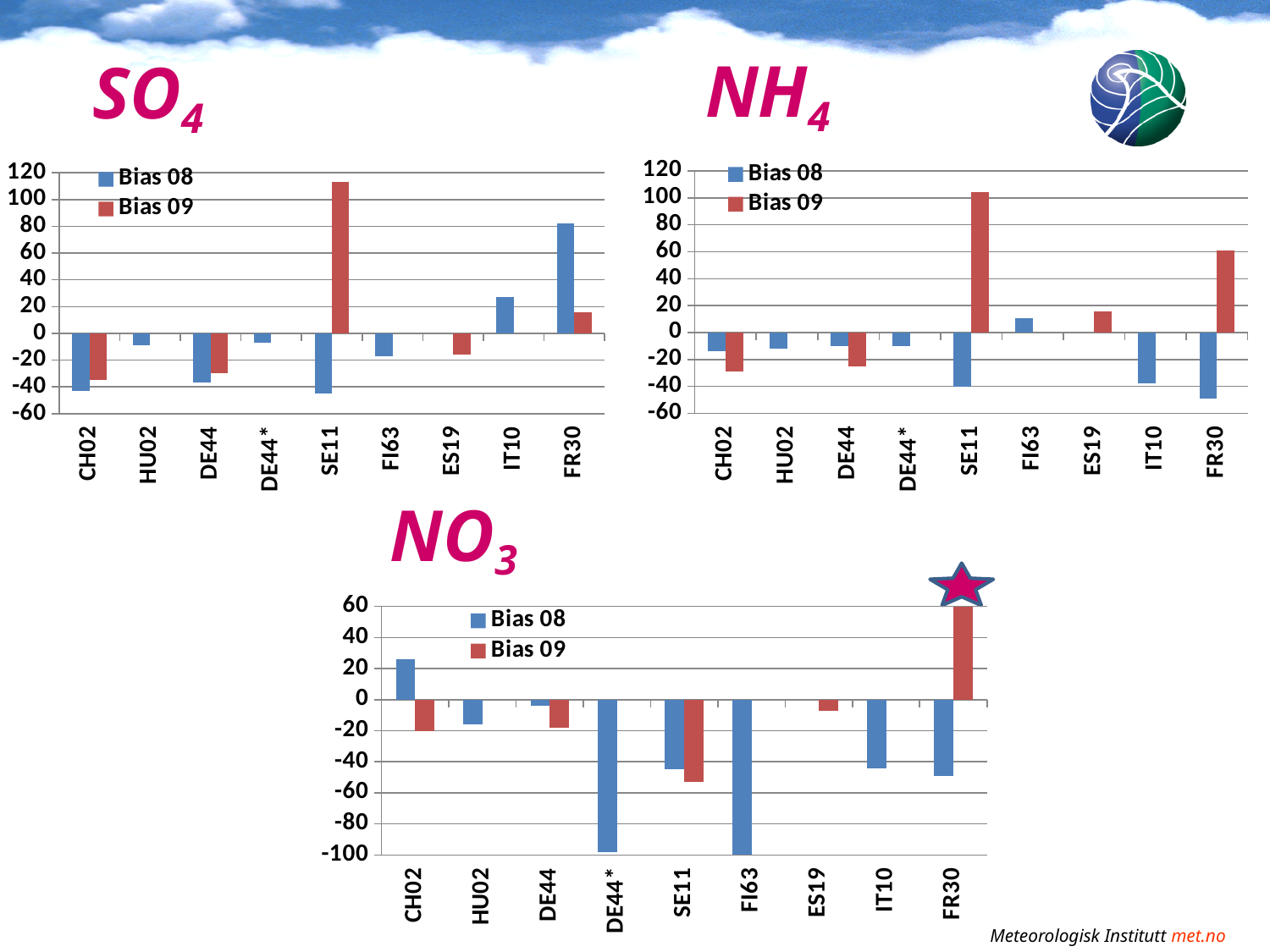
What kind of chart is the NH4 chart? bar chart In the NO3 chart, is the Bias 08 value for CH02 greater or less than 20? greater In the NH4 chart, which category has the highest Bias 09 value? SE11 In the SO4 chart, which category has the highest Bias 09 value? SE11 In the NH4 chart, which category has the lowest Bias 08 value? FR30 How many categories are shown on the x axis of the NO3 chart? 9 In the NH4 chart, is the Bias 09 value for FR30 greater or less than 40? greater In the SO4 chart, is the Bias 08 value for FR30 greater or less than 60? greater In the SO4 chart, which is larger for FR30: Bias 08 or Bias 09? Bias 08 In the NO3 chart, which category has the highest Bias 09 value? FR30 How many series does the legend of the SO4 chart list? 2